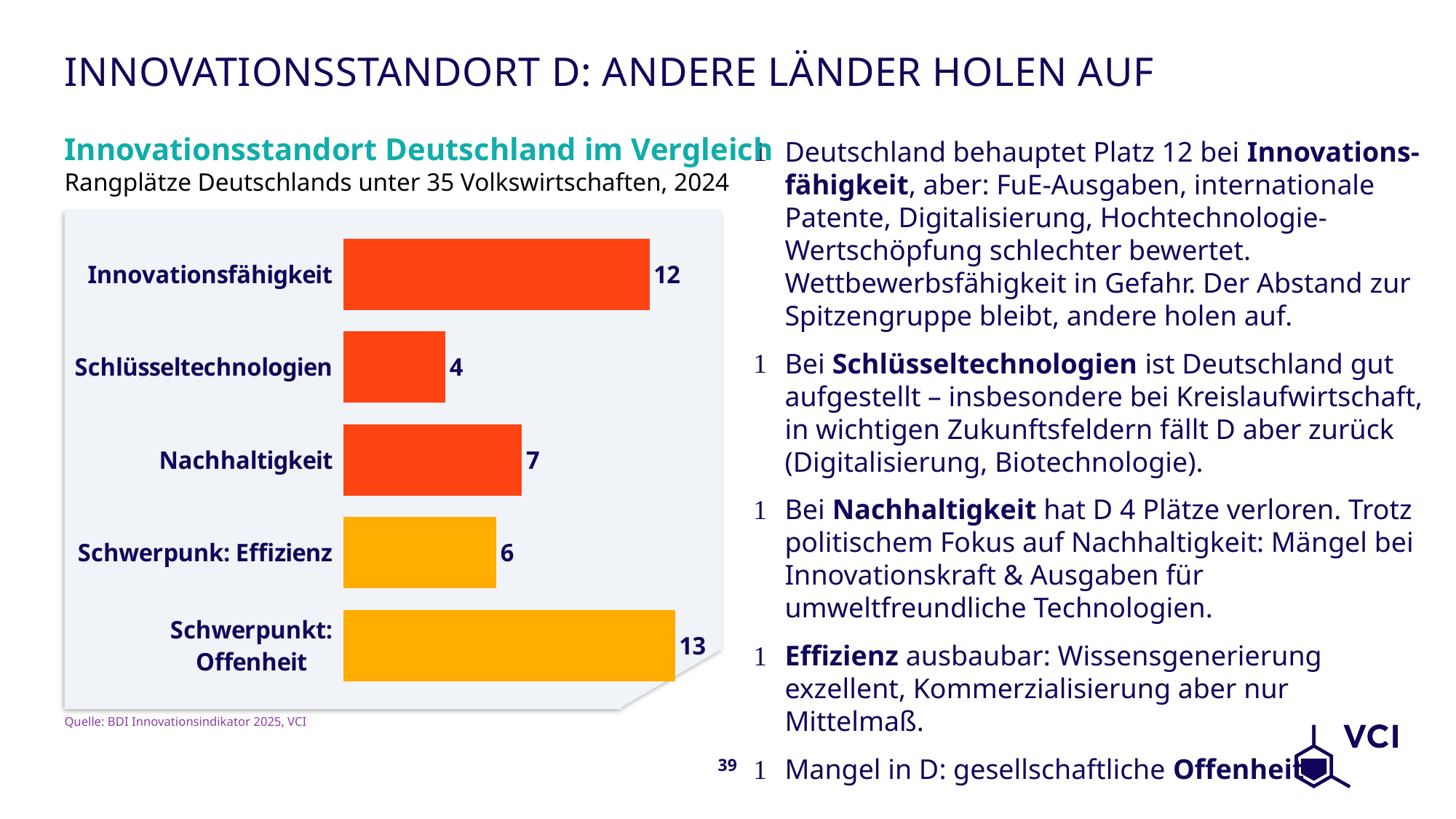
What is the source cited below the chart? BDI Innovationsindikator 2025, VCI What is the rank value shown for Innovationsfähigkeit? 12 Which category has the longest bar (highest value)? Schwerpunkt: Offenheit What is the rank value shown for Nachhaltigkeit? 7 What is the rank value shown for Schlüsseltechnologien? 4 What is the rank value shown for Schwerpunkt: Offenheit? 13 How many categories are shown in the chart? 5 Which category has the shortest bar (lowest value)? Schlüsseltechnologien Which has the larger value, Nachhaltigkeit or Schwerpunk: Effizienz? Nachhaltigkeit What kind of chart is shown on the slide? Bar chart What is the difference between the values for Innovationsfähigkeit and Schlüsseltechnologien? 8 What is the title of the chart? Innovationsstandort Deutschland im Vergleich